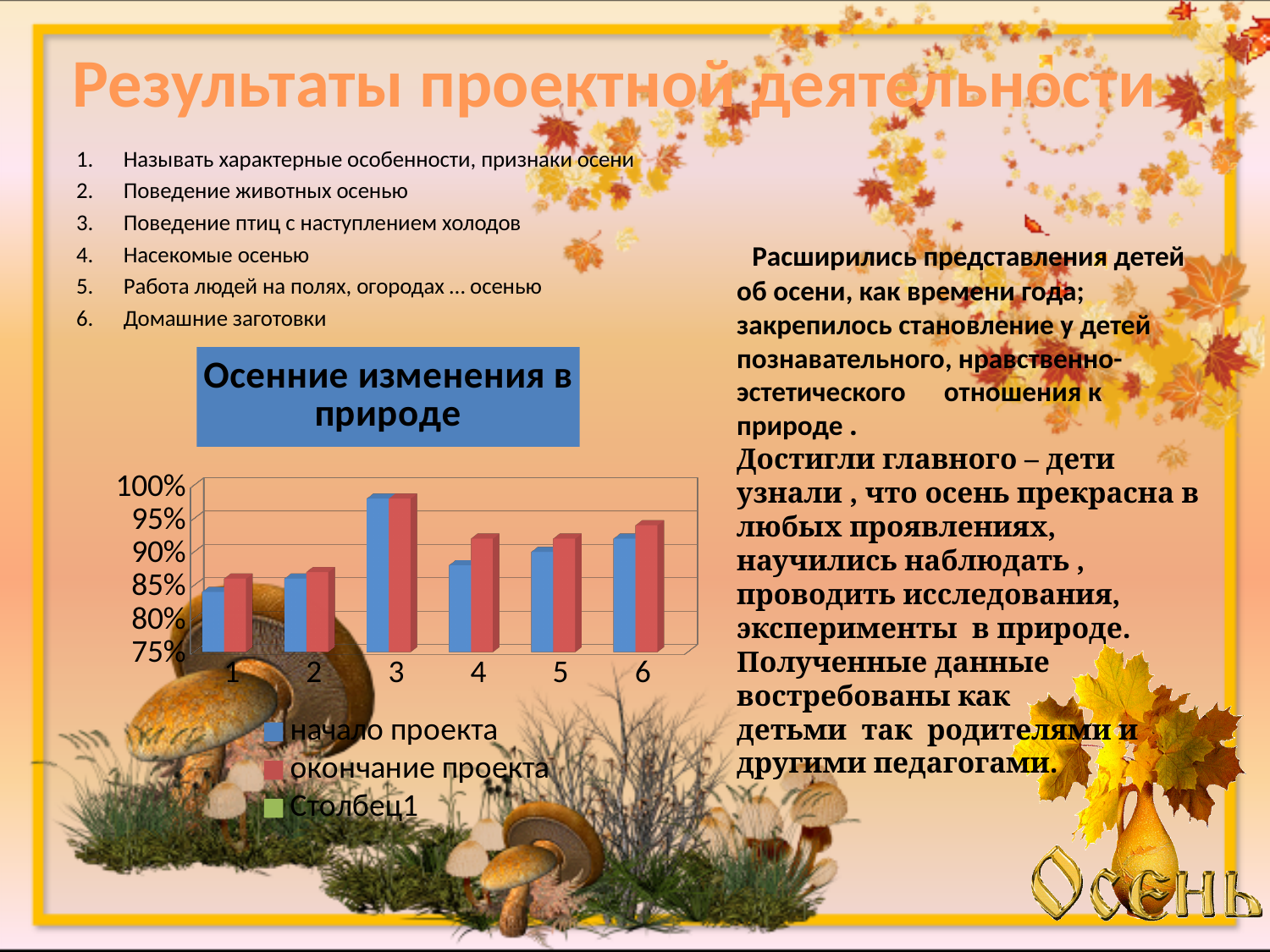
Is the value for окончание проекта in category 6 greater or less than 90%? greater Which category has the highest value for начало проекта? 3 What kind of chart is shown on the slide? bar chart How many categories are shown on the x axis of the chart? 6 How many series does the chart legend list? 3 Is the value for начало проекта in category 3 greater or less than 95%? greater What is the title of the chart? Осенние изменения в природе Which series is shown in blue in the chart? начало проекта Which category has the highest value for окончание проекта? 3 Which category has the lowest value for начало проекта? 1 In category 4, which is larger: начало проекта or окончание проекта? окончание проекта